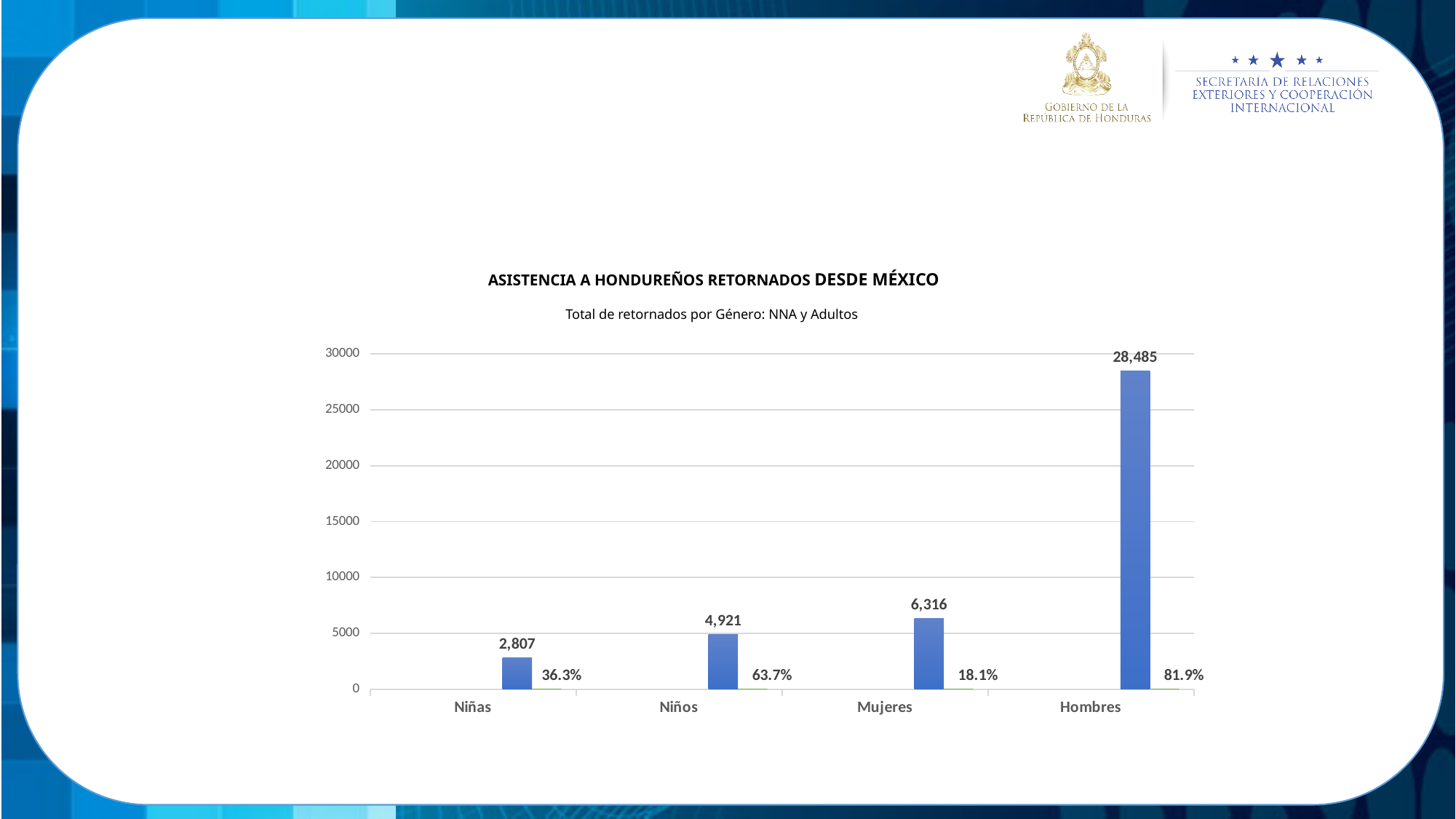
Which is larger, the value for Mujeres or the value for Niños? Mujeres Which category has the lowest value? Niñas What kind of chart is shown? bar chart What is the difference between the values for Niños and Niñas? 2,114 What percentage label is shown for Niños? 63.7% How many categories are shown on the x axis? 4 What is the value for Niñas? 2,807 Is the value for Hombres greater or less than 25000? greater Which category has the highest value? Hombres What is the value for Hombres? 28,485 What is the value for Mujeres? 6,316 What is the subtitle of the chart? Total de retornados por Género: NNA y Adultos